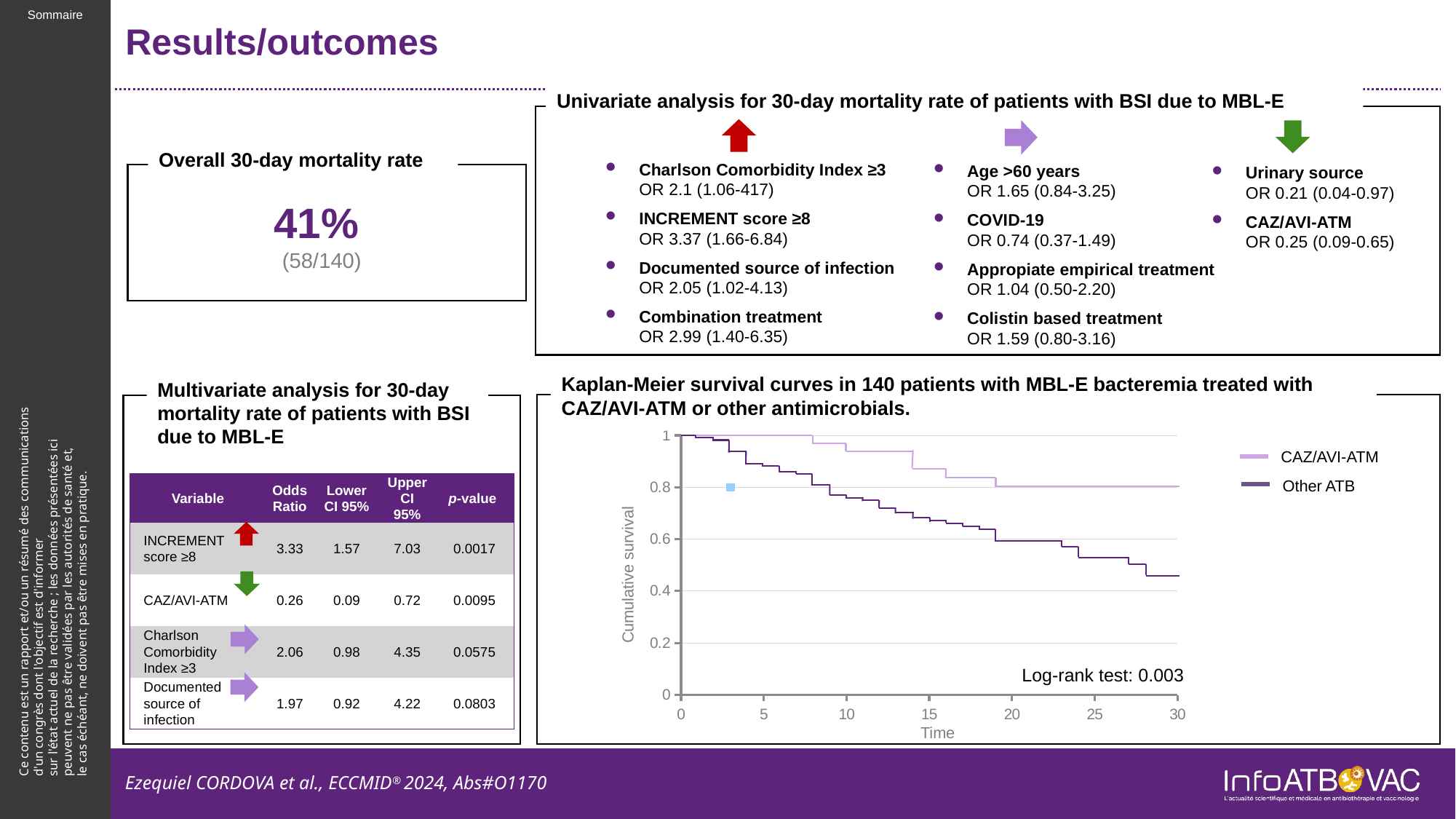
In the Kaplan-Meier survival chart, is the cumulative survival of the CAZ/AVI-ATM group at time 30 greater or less than 0.6? greater In the Kaplan-Meier survival chart, is the cumulative survival of the Other ATB group at time 30 greater or less than 0.6? less In the Kaplan-Meier survival chart, is the cumulative survival of the Other ATB group at time 10 greater or less than 0.6? greater What kind of chart is shown in the Kaplan-Meier survival curves panel? Line chart (Kaplan-Meier survival curves) What is the maximum value shown on the x axis (Time) of the Kaplan-Meier survival chart? 30 In the Kaplan-Meier survival chart, which two groups are compared according to the legend? CAZ/AVI-ATM and Other ATB In the Kaplan-Meier survival chart, do the survival curves rise or fall as time increases? Fall In the Kaplan-Meier survival chart, what is the label of the y axis? Cumulative survival How many series does the legend of the Kaplan-Meier survival chart list? 2 What log-rank test value is printed on the Kaplan-Meier survival chart? 0.003 In the Kaplan-Meier survival chart, which curve is higher at time 30: CAZ/AVI-ATM or Other ATB? CAZ/AVI-ATM